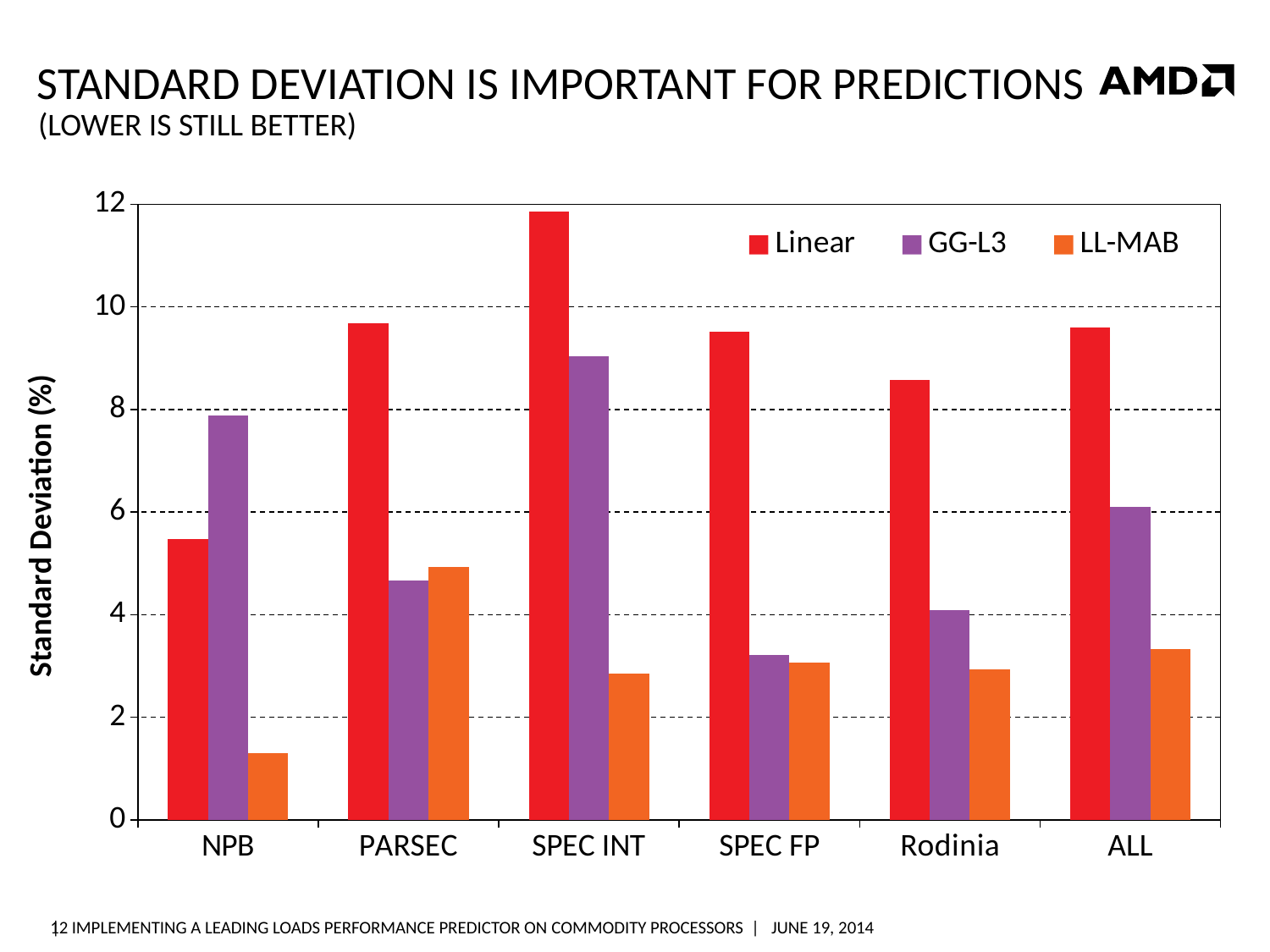
For which category is the Linear series highest? SPEC INT What is the label on the y axis? Standard Deviation (%) Is the Linear value for SPEC INT greater or less than 10? greater For which category is the LL-MAB series lowest? NPB What kind of chart is shown on the slide? bar chart How many series does the legend list? 3 For Rodinia, which is larger: the GG-L3 value or the LL-MAB value? GG-L3 Is the LL-MAB value for NPB greater or less than 2? less For which category is the GG-L3 series highest? SPEC INT For NPB, which is larger: the Linear value or the GG-L3 value? GG-L3 How many benchmark categories are shown on the x axis? 6 Is the Linear value for Rodinia greater or less than 8? greater